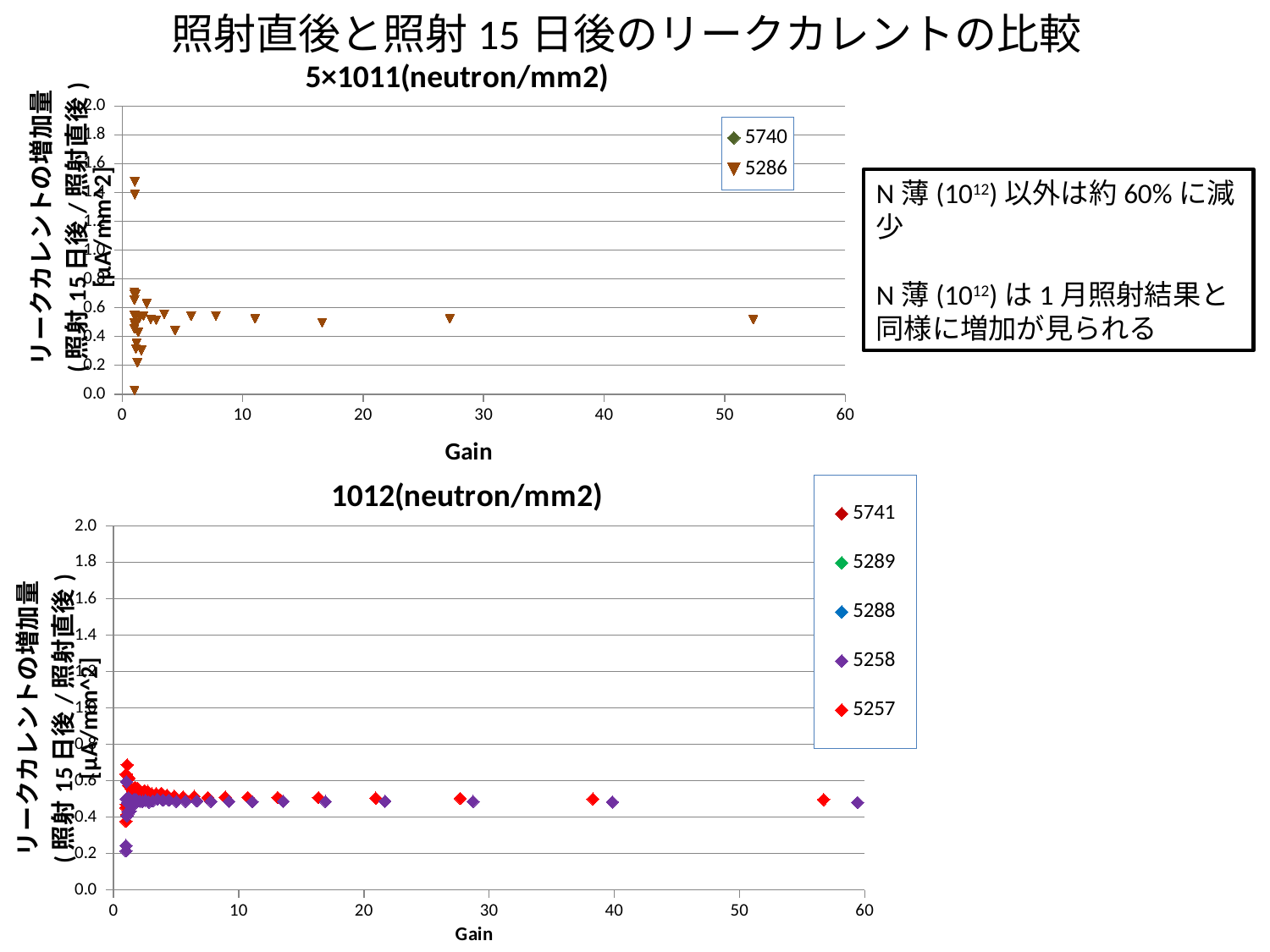
In the bottom chart (1012(neutron/mm2)), do the values rise, fall, or stay roughly flat as gain increases beyond 10? stay roughly flat What kind of chart is the bottom chart titled 1012(neutron/mm2)? scatter chart In the bottom chart (1012(neutron/mm2)), is the value of the 5257 series at a gain of about 57 greater or less than 1.0? less In the top chart (5×1011(neutron/mm2)), which series is shown with triangle markers? 5286 How many series does the legend of the top chart (5×1011(neutron/mm2)) list? 2 What kind of chart is the top chart titled 5×1011(neutron/mm2)? scatter chart How many series does the legend of the bottom chart (1012(neutron/mm2)) list? 5 In the top chart (5×1011(neutron/mm2)), is the value of the 5286 series at a gain of about 52 greater or less than 1.0? less In the top chart (5×1011(neutron/mm2)), is the highest point of the 5286 series greater or less than 1.2? greater What is the maximum value shown on the y axis of the top chart (5×1011(neutron/mm2))? 2.0 What is the label of the x axis on the bottom chart (1012(neutron/mm2))? Gain